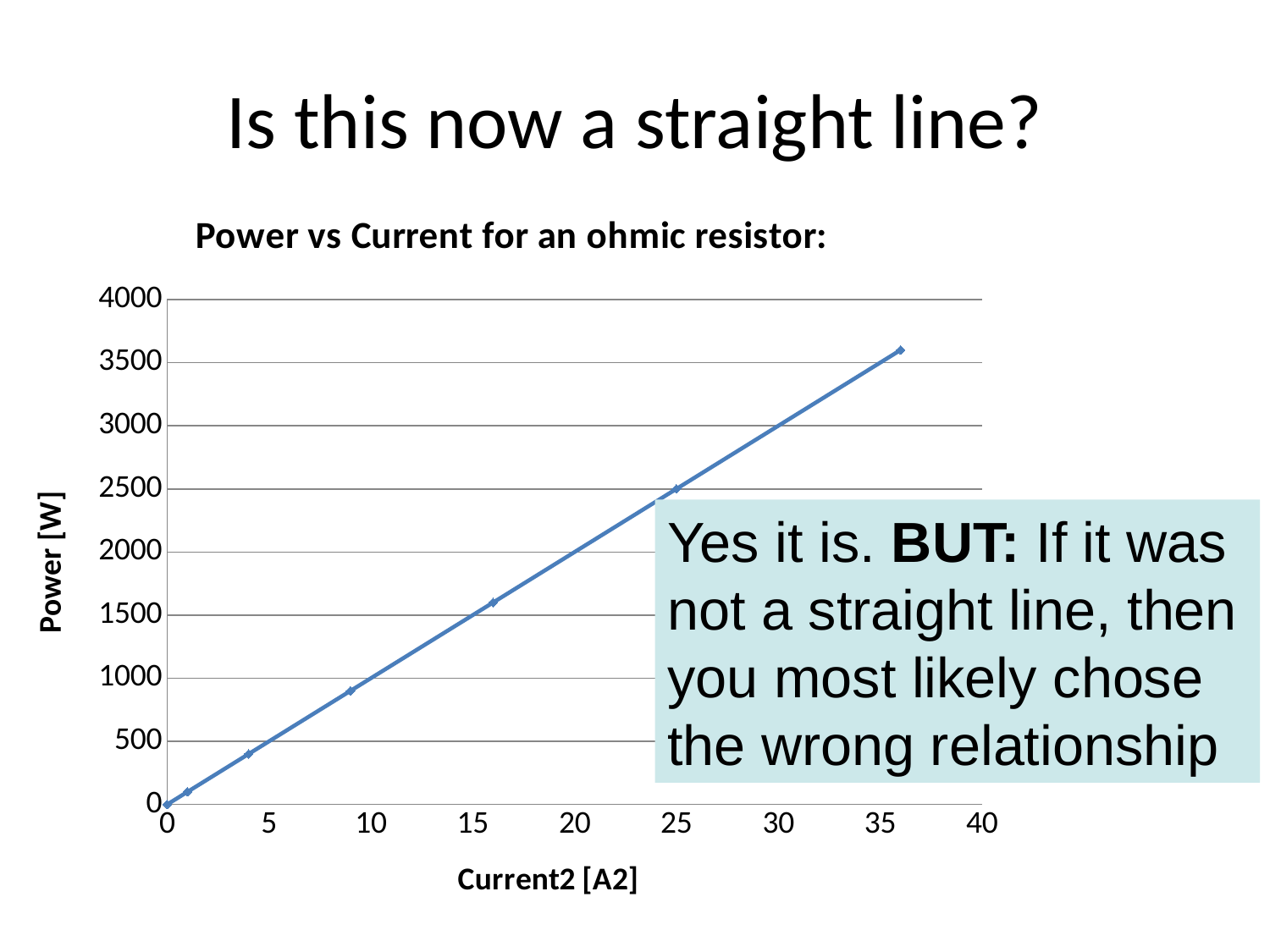
What type of chart is shown on the slide? line chart How many data points are plotted on the line? 7 What is the title of the chart? Power vs Current for an ohmic resistor: Which plotted point has the highest Power value? the point at Current2 = 36 Is the Power value at Current2 = 9 greater or less than 1000? less What is the label of the vertical axis? Power [W] Which is larger, the Power value at Current2 = 25 or at Current2 = 16? Current2 = 25 What is the Power value at Current2 = 0? 0 Is the Power value at Current2 = 36 greater or less than 3500? greater Is the Power value at Current2 = 16 greater or less than 1500? greater Do the plotted values rise or fall as the x-axis value increases? rise What is the Power value at Current2 = 25? 2500